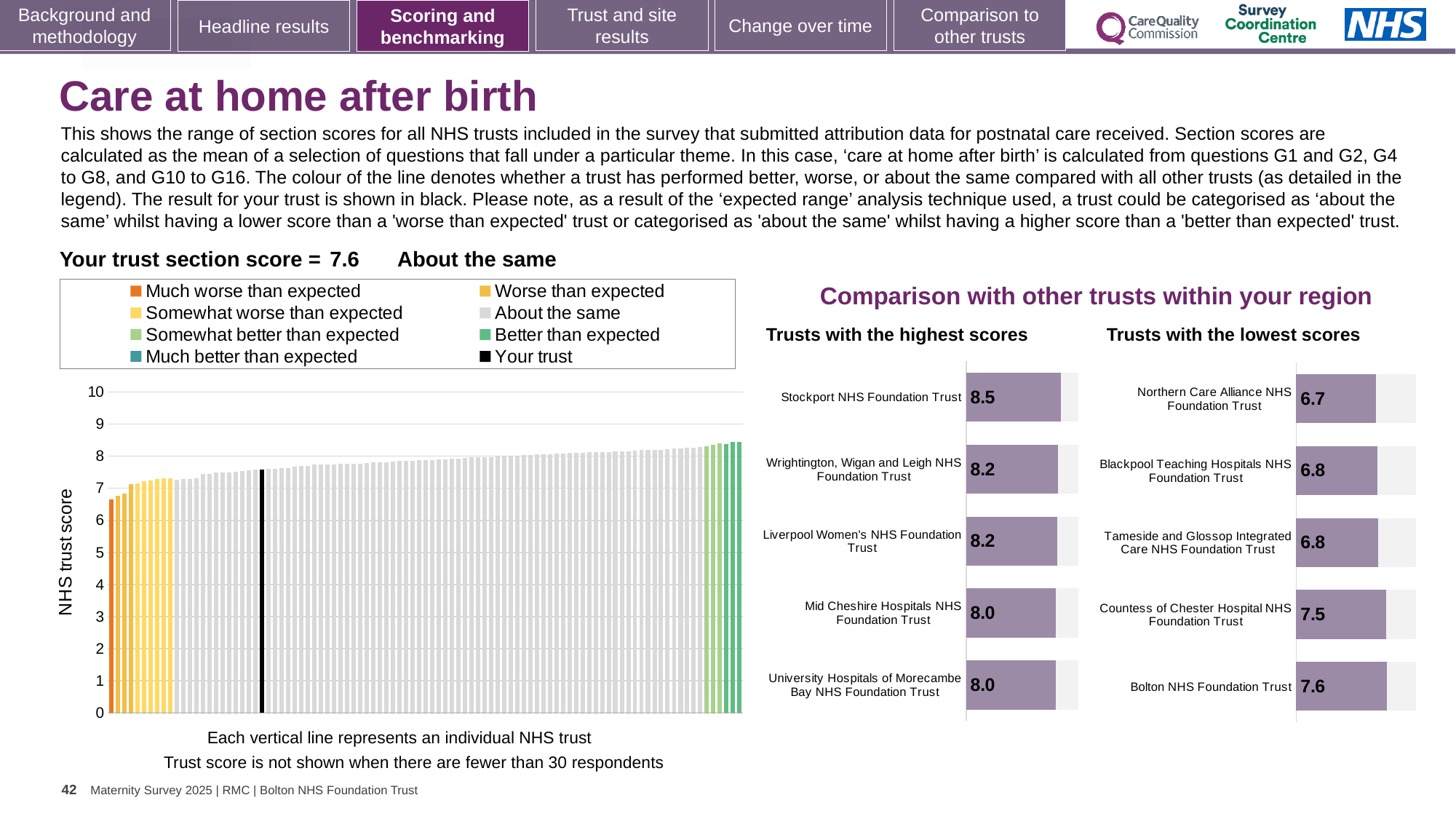
In the large 'NHS trust score' chart on the left, what is the section score for your trust (the black line)? 7.6 How many entries does the legend above the large 'NHS trust score' chart list? 8 In the 'Trusts with the highest scores' chart, what is the difference between the scores of Stockport NHS Foundation Trust and University Hospitals of Morecambe Bay NHS Foundation Trust? 0.5 How many trusts are shown in the 'Trusts with the highest scores' chart? 5 In the 'Trusts with the lowest scores' chart, what is the score for Northern Care Alliance NHS Foundation Trust? 6.7 In the 'Trusts with the highest scores' chart, which trust has the highest score? Stockport NHS Foundation Trust In the 'Trusts with the lowest scores' chart, what is the difference between the scores of Bolton NHS Foundation Trust and Northern Care Alliance NHS Foundation Trust? 0.9 In the 'Trusts with the lowest scores' chart, which has the larger score: Countess of Chester Hospital NHS Foundation Trust or Bolton NHS Foundation Trust? Bolton NHS Foundation Trust What kind of chart is the large 'NHS trust score' chart on the left of the slide? Bar chart In the large 'NHS trust score' chart on the left, do the values rise or fall from left to right? Rise In the 'Trusts with the lowest scores' chart, which trust has the lowest score? Northern Care Alliance NHS Foundation Trust In the 'Trusts with the highest scores' chart, what is the score for Stockport NHS Foundation Trust? 8.5